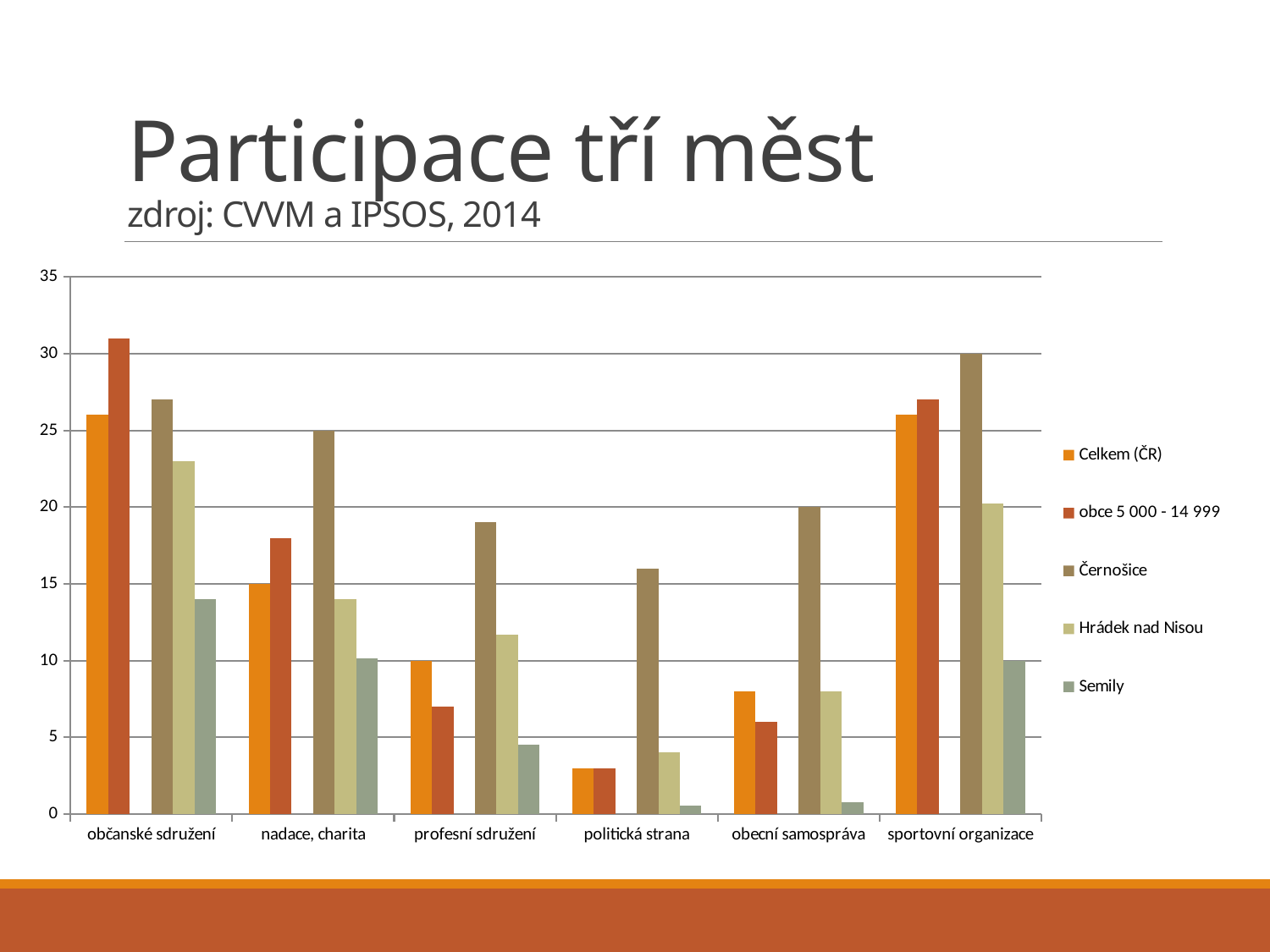
How many categories are shown on the x axis? 6 Is the value for Semily in the politická strana category greater or less than 5? less Which series has the lowest value in the občanské sdružení category? Semily In the nadace, charita category, which is larger: Celkem (ČR) or obce 5 000 - 14 999? obce 5 000 - 14 999 What is the value for Celkem (ČR) in the nadace, charita category? 15 What is the title of the slide containing the chart? Participace tří měst How many series does the legend list? 5 What is the value for Černošice in the sportovní organizace category? 30 What is the value for Černošice in the obecní samospráva category? 20 Which series has the highest value in the politická strana category? Černošice What kind of chart is shown on the slide? bar chart Is the value for obce 5 000 - 14 999 in the občanské sdružení category greater or less than 30? greater